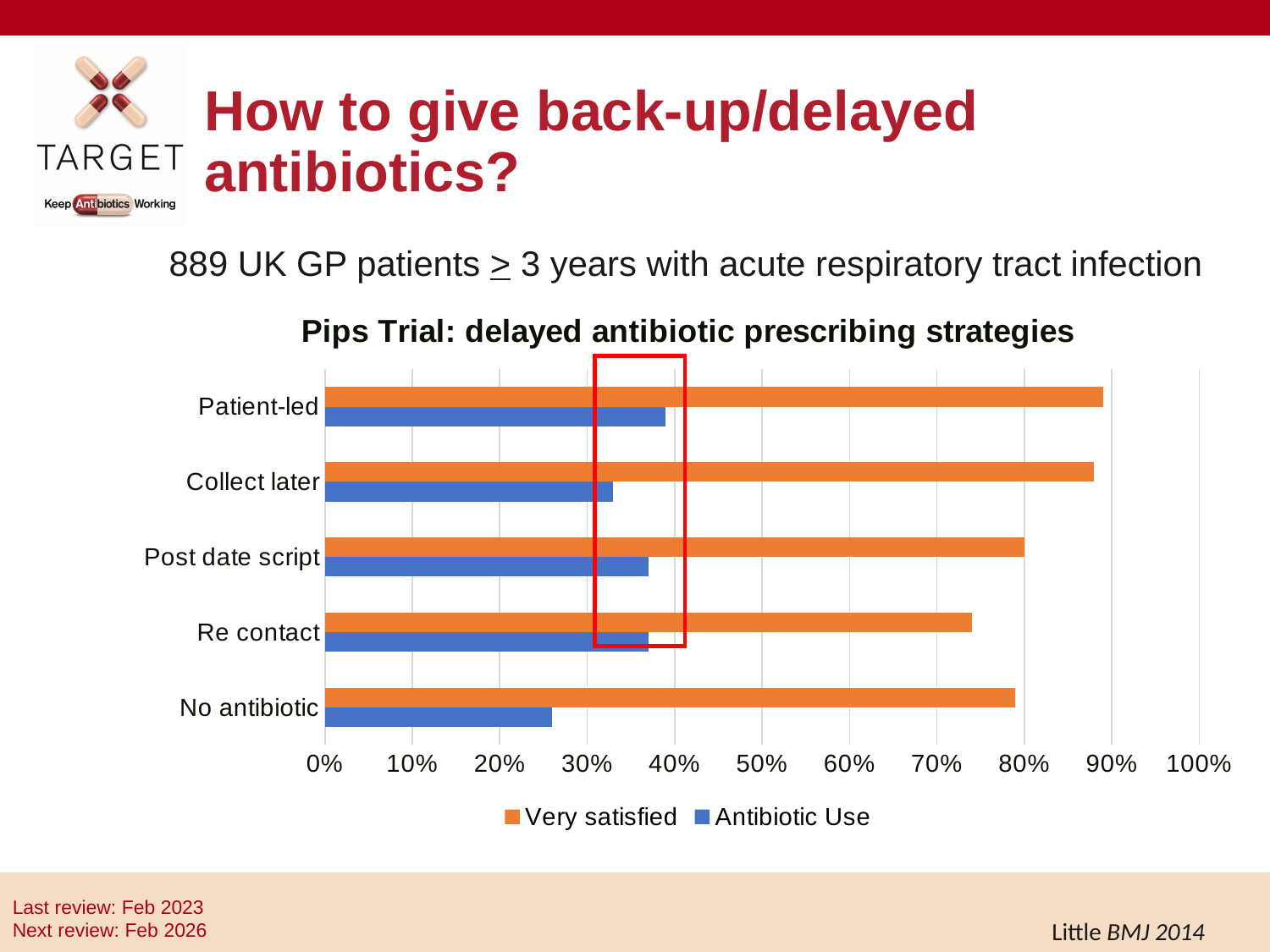
Is the Very satisfied value for Patient-led greater or less than 80%? greater Which strategy has the lowest Antibiotic Use value? No antibiotic How many prescribing strategies (categories) are shown on the chart? 5 What is the title of the chart? Pips Trial: delayed antibiotic prescribing strategies Is the Antibiotic Use value for No antibiotic greater or less than 30%? less Which series is shown in orange? Very satisfied What kind of chart is shown on the slide? Bar chart Which has the larger Very satisfied value, Post date script or Re contact? Post date script Which strategy has the lowest Very satisfied value? Re contact How many series does the chart legend list? 2 Is the Very satisfied value for Re contact greater or less than 80%? less Which has the larger Antibiotic Use value, Patient-led or Collect later? Patient-led